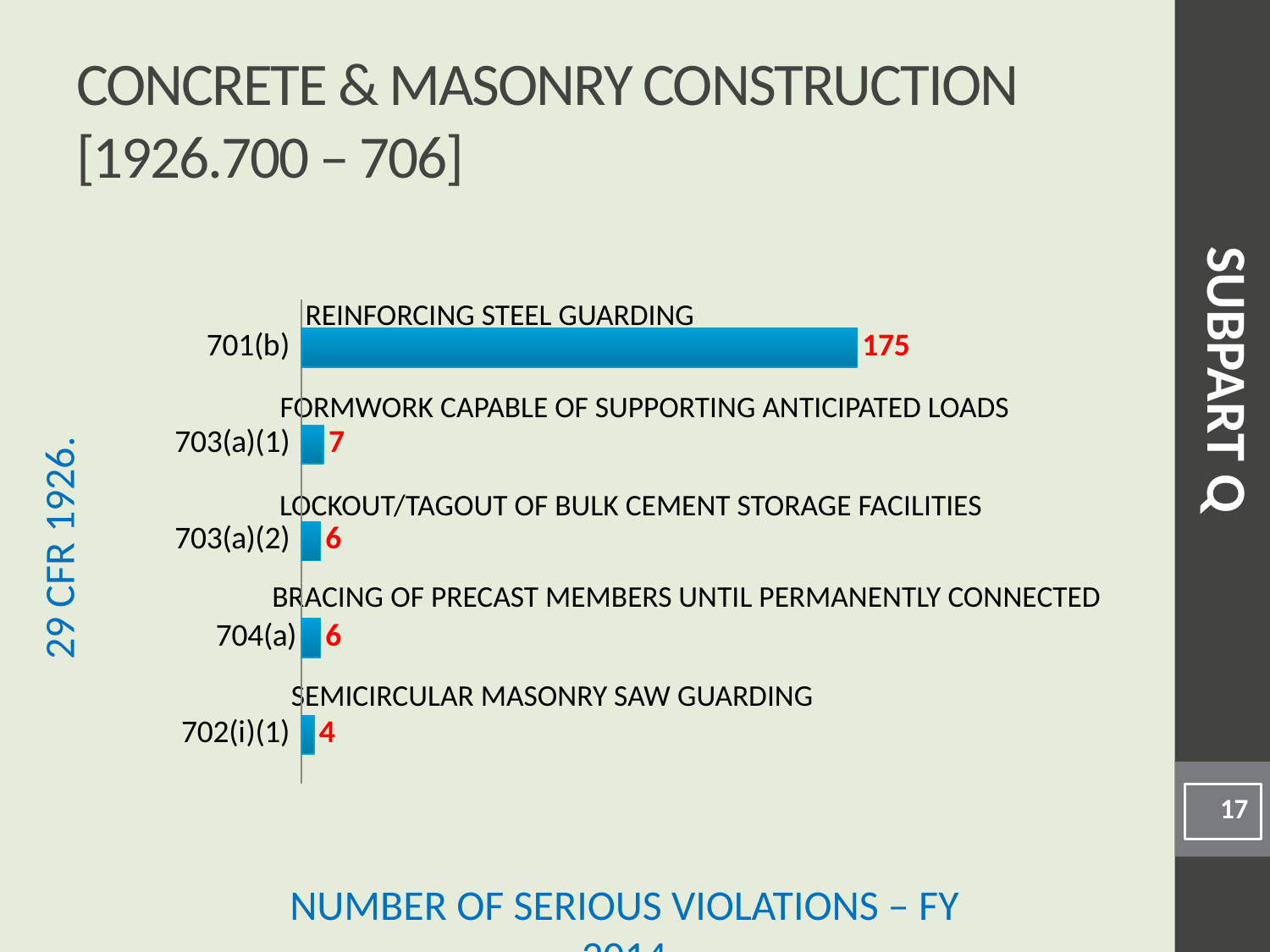
What is the number of serious violations for 701(b)? 175 Which category has the lowest number of serious violations? 702(i)(1) What is the description label shown above the bar for 703(a)(2)? LOCKOUT/TAGOUT OF BULK CEMENT STORAGE FACILITIES What is the number of serious violations for 703(a)(1)? 7 What is the difference between the values for 701(b) and 703(a)(1)? 168 What kind of chart is shown on the slide? Bar chart What is the number of serious violations for 702(i)(1)? 4 How many categories are shown in the chart? 5 Which has a larger value, 703(a)(1) or 702(i)(1)? 703(a)(1) What is the number of serious violations for 704(a)? 6 What is the description label shown above the bar for 701(b)? REINFORCING STEEL GUARDING Which category has the highest number of serious violations? 701(b)